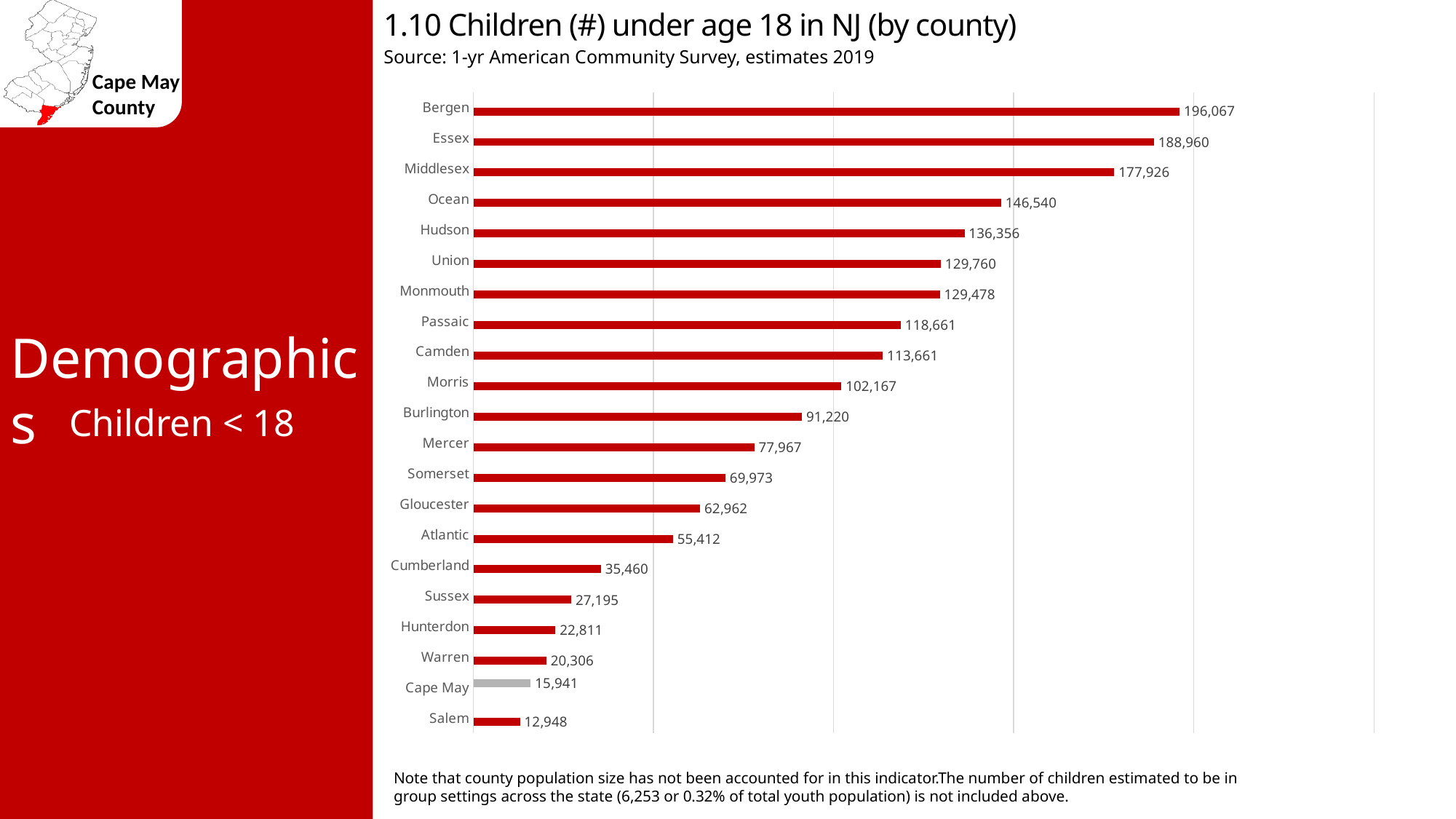
What is the number of children under age 18 in Cape May County? 15,941 Which county has the lowest number of children under age 18? Salem Which county has more children under age 18, Warren or Hunterdon? Hunterdon What is the number of children under age 18 in Burlington County? 91,220 What is the number of children under age 18 in Ocean County? 146,540 What kind of chart is shown on the slide? Bar chart What is the difference between the number of children under 18 in Cape May and Salem counties? 2,993 Which county's bar is shown in grey rather than red? Cape May How many counties are shown in the chart? 21 Which county has more children under age 18, Morris or Camden? Camden What is the difference between the number of children under 18 in Bergen and Essex counties? 7,107 Which county has the highest number of children under age 18? Bergen